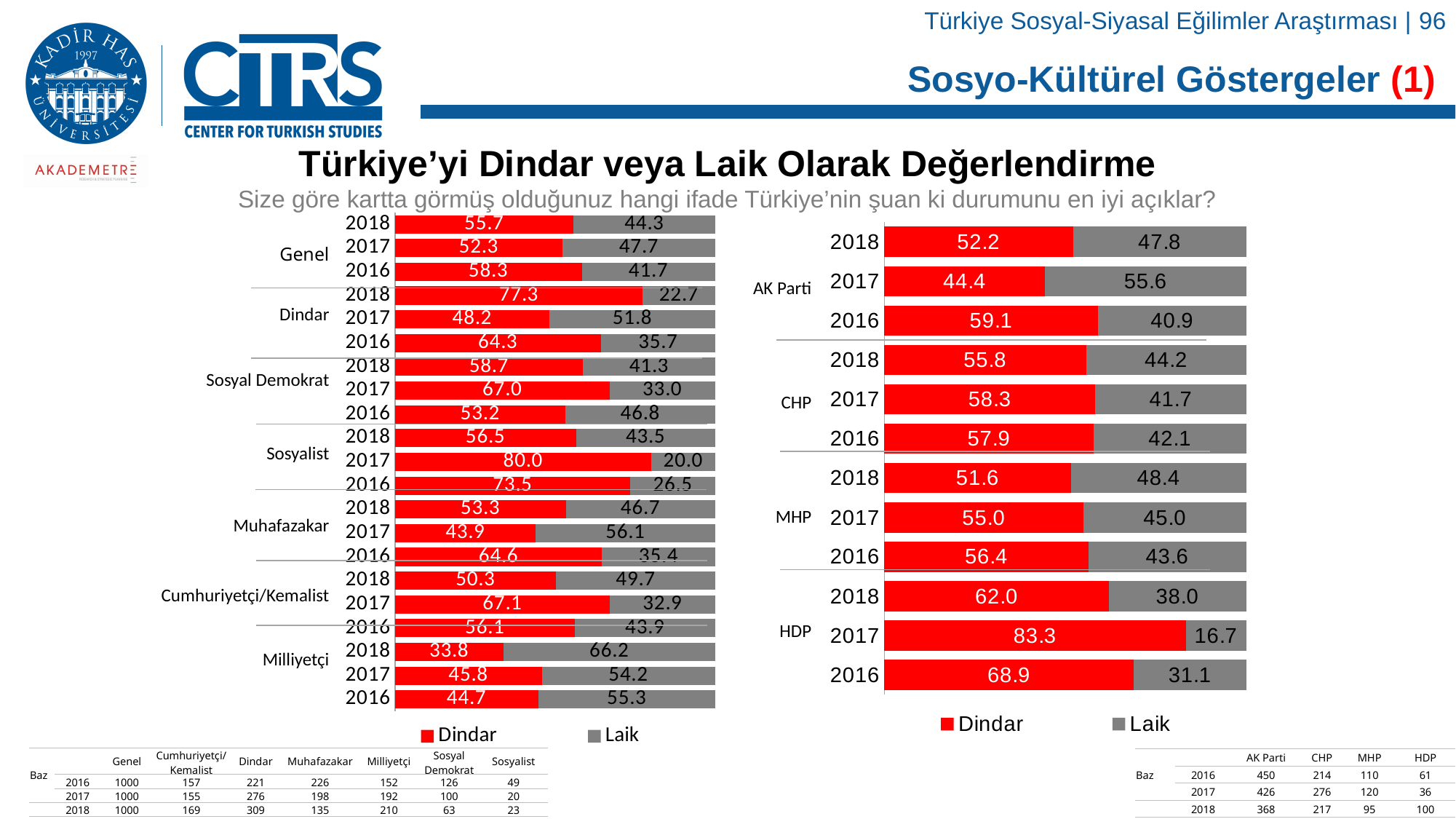
In the right chart, which party and year has the highest Dindar value? HDP 2017 In the left chart, what is the difference between the Dindar values for Dindar 2018 and Dindar 2017? 29.1 In the left chart, what is the total of the Dindar and Laik values for Sosyalist 2017? 100.0 In the right chart, which is larger: the Dindar value for CHP 2018 or for MHP 2018? CHP 2018 In the left chart, which group and year has the lowest Dindar value? Milliyetçi 2018 In the left chart, what is the Dindar value for Genel in 2018? 55.7 In the right chart, does the Dindar value for HDP rise or fall from 2017 to 2018? Fall In the right chart, what is the Laik value for AK Parti in 2017? 55.6 How many series does the legend of the right chart list? 2 Which colour represents Laik in the charts? Grey What kind of chart is the left chart? Stacked bar chart How many parties are shown in the right chart? 4